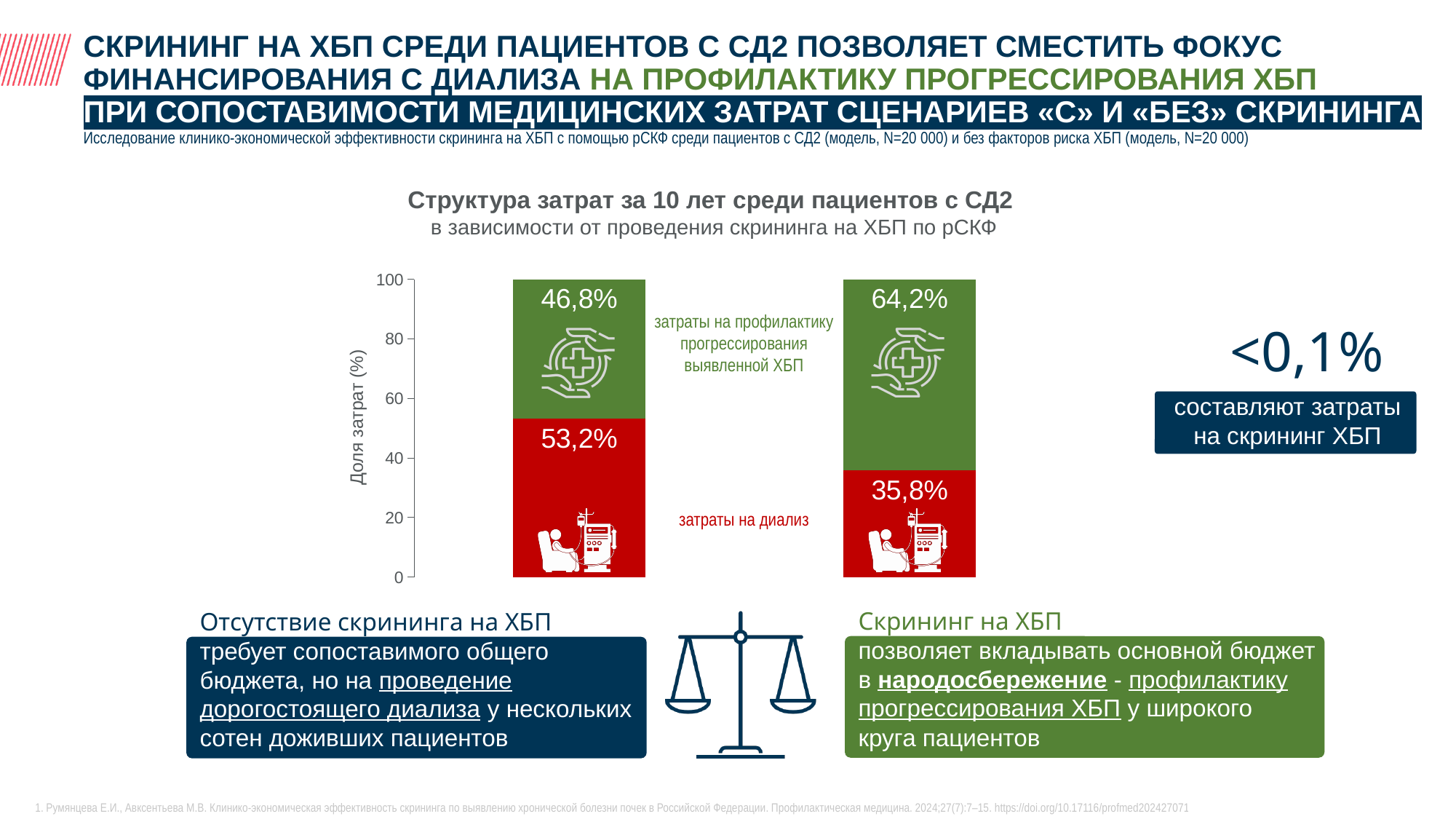
How many cost categories (segments) does each bar contain? 2 What type of chart is shown on the slide? Stacked bar chart What colour represents dialysis costs (затраты на диализ) in the chart? Red What is the share of costs for prevention of CKD progression in the right bar? 64,2% What is the share of costs for prevention of CKD progression (затраты на профилактику прогрессирования выявленной ХБП) in the left bar? 46,8% How many bars are plotted in the chart? 2 What is the title of the y axis? Доля затрат (%) What is the total of the two segments in the right bar? 100% What is the share of dialysis costs (затраты на диализ) in the left bar? 53,2% What is the share of dialysis costs (затраты на диализ) in the right bar? 35,8% Which bar has the larger share of dialysis costs, the left or the right? Left What is the difference between the dialysis cost share in the left bar and in the right bar? 17,4%